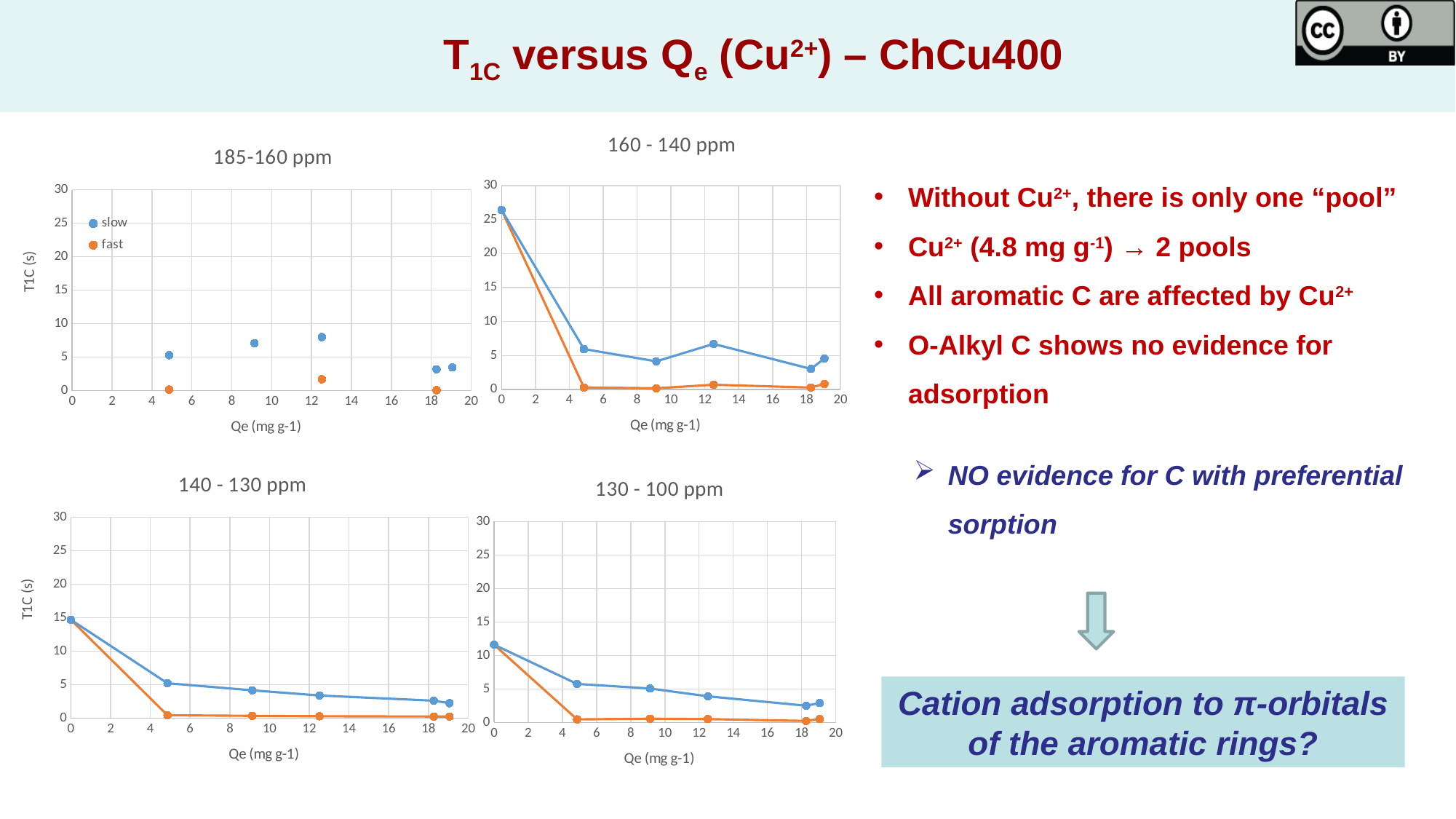
In the "160 - 140 ppm" chart, does the slow series overall rise or fall as Qe increases? fall In the "185-160 ppm" chart, is the slow value at Qe of about 12.5 greater or less than 5? greater How many slow data points are plotted in the "185-160 ppm" chart? 5 In the "140 - 130 ppm" chart, at Qe of about 5, which series has the larger value, slow or fast? slow In the "130 - 100 ppm" chart, is the slow value at Qe = 0 greater or less than 10? greater In the "140 - 130 ppm" chart, is the slow value at Qe = 0 greater or less than 10? greater Which chart has the higher slow value at Qe = 0, "160 - 140 ppm" or "130 - 100 ppm"? 160 - 140 ppm What is the x-axis label of the "130 - 100 ppm" chart? Qe (mg g-1) How many series does the legend of the "185-160 ppm" chart list? 2 What are the two legend entries in the "185-160 ppm" chart? slow and fast What kind of chart is the "185-160 ppm" chart? scatter chart